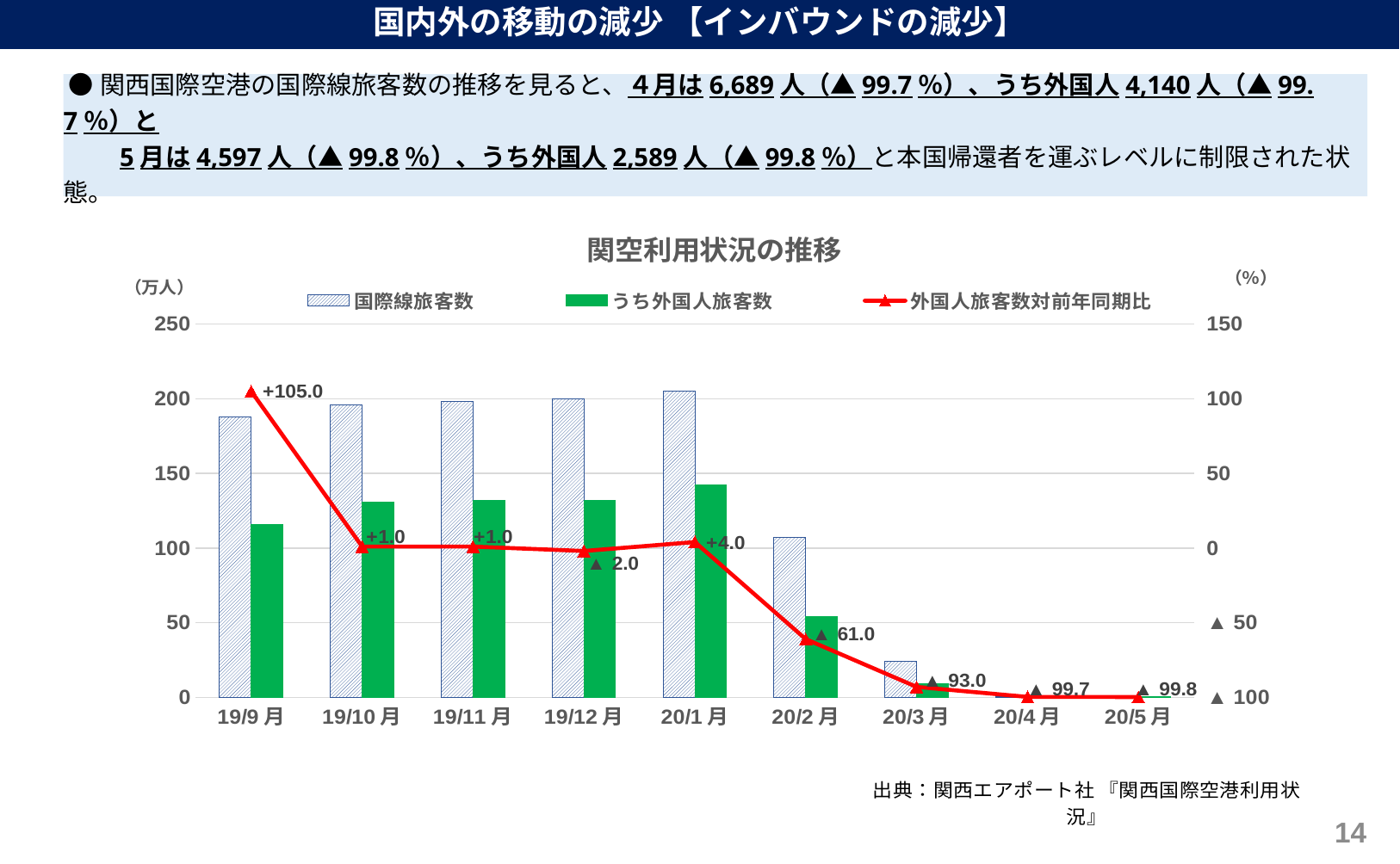
How many series does the chart legend list? 3 Which month has the highest value of 外国人旅客数対前年同期比? 19/9月 What is the title of the chart? 関空利用状況の推移 Which month has the lowest value of 外国人旅客数対前年同期比? 20/5月 Is the うち外国人旅客数 value for 20/1月 greater or less than 100? greater What kind of chart is shown on the slide? Combined bar and line chart What is the value of 外国人旅客数対前年同期比 for 20/5月? ▲99.8 What is the value of 外国人旅客数対前年同期比 for 19/9月? +105.0 Is the 国際線旅客数 value for 19/9月 greater or less than 150? greater How many months are shown on the x axis of the chart? 9 Does the 外国人旅客数対前年同期比 line rise or fall from 20/1月 to 20/5月? Fall What is the value of 外国人旅客数対前年同期比 for 20/2月? ▲61.0